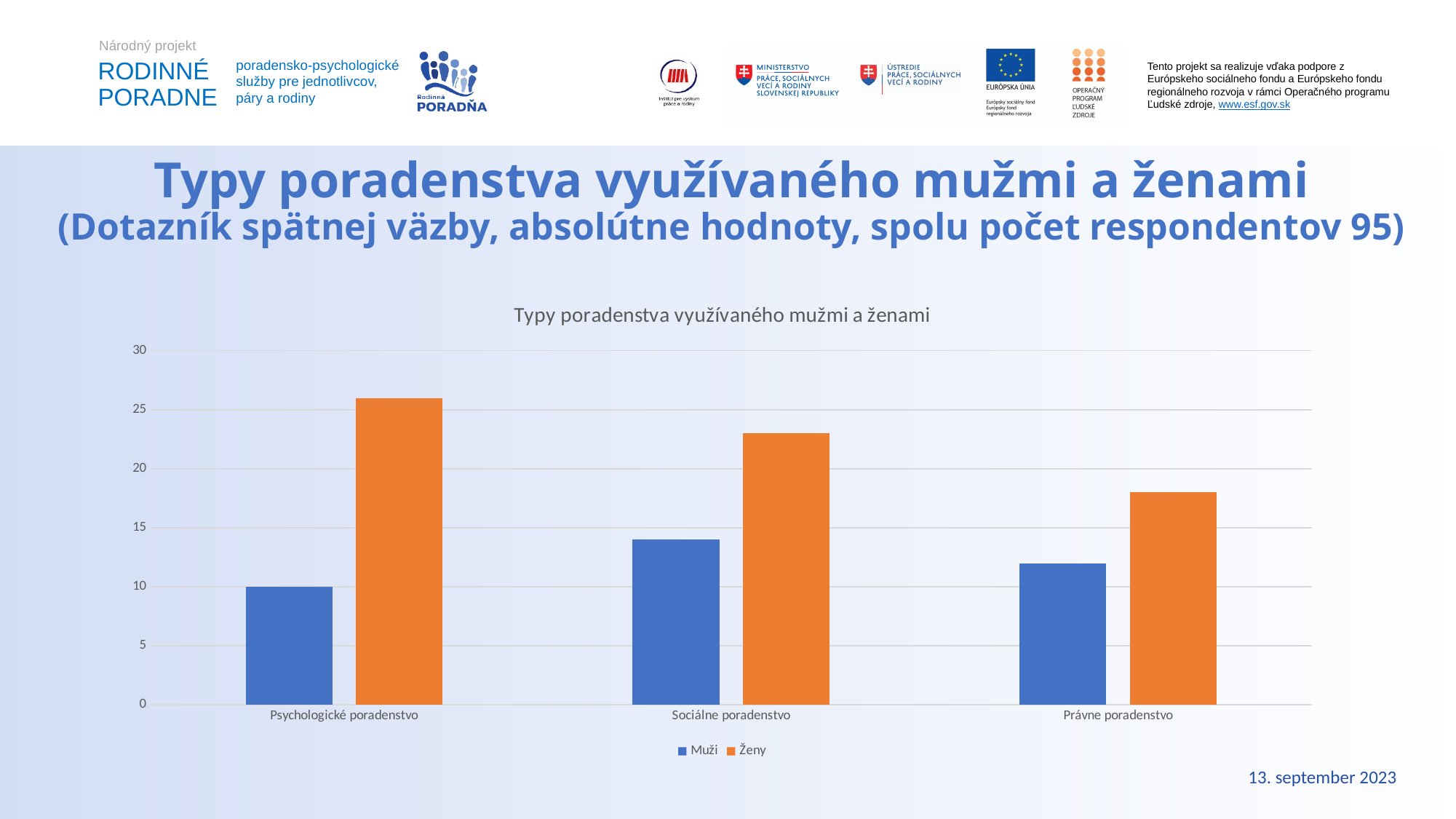
How many series does the legend list? 2 Is the value for Muži in Sociálne poradenstvo greater or less than 15? less Which category has the highest value for Ženy? Psychologické poradenstvo Which category has the lowest value for Ženy? Právne poradenstvo Which category has the highest value for Muži? Sociálne poradenstvo Which category has the lowest value for Muži? Psychologické poradenstvo How many categories are shown on the x axis? 3 Is the value for Ženy in Psychologické poradenstvo greater or less than 25? greater What is the value for Muži in Psychologické poradenstvo? 10 In Právne poradenstvo, which is larger, Muži or Ženy? Ženy What is the title of the chart? Typy poradenstva využívaného mužmi a ženami What type of chart is shown on the slide? bar chart